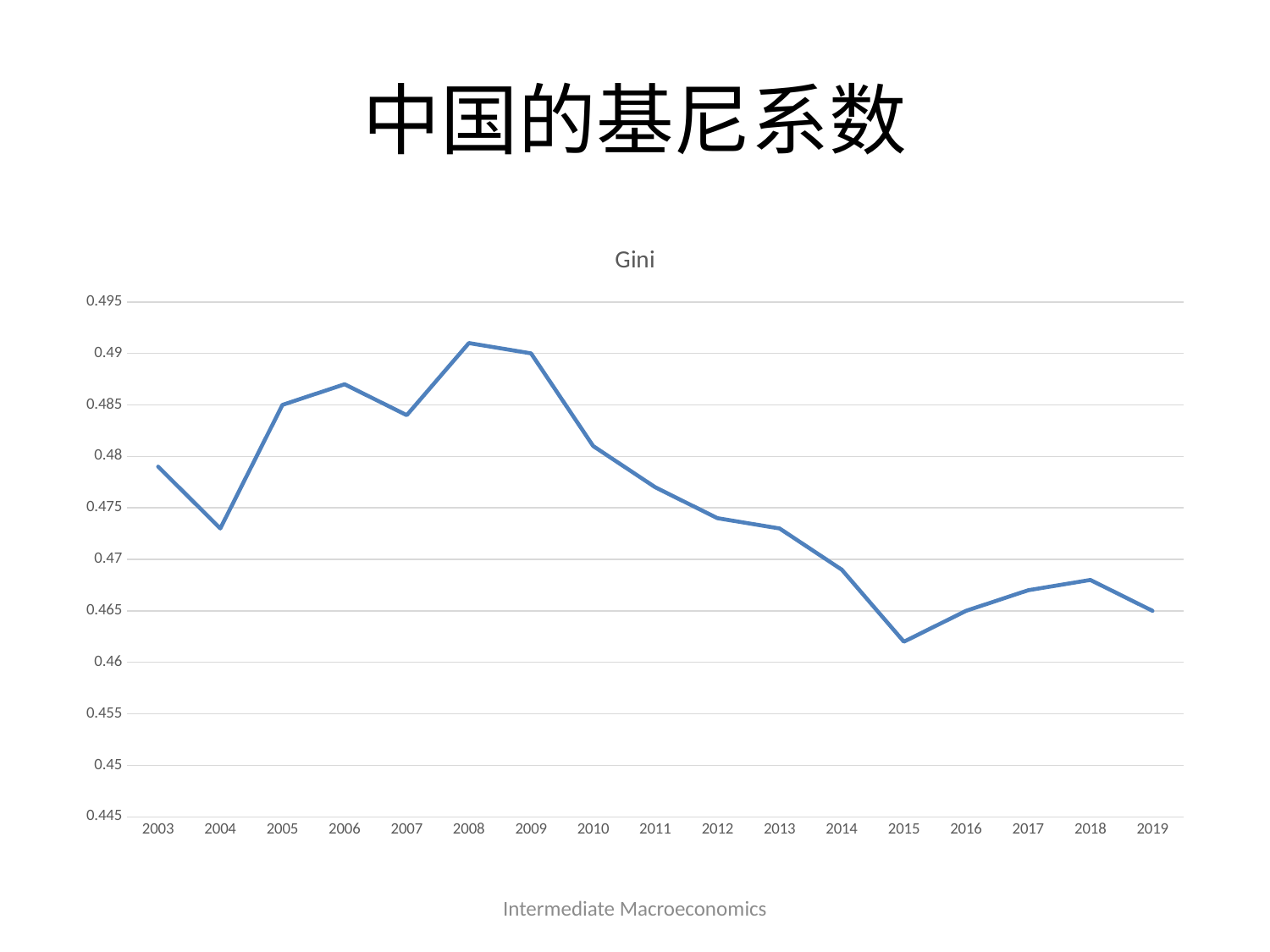
What is the Gini value for 2009? 0.49 Is the Gini value for 2015 greater or less than 0.465? less What is the Gini value for 2019? 0.465 Is the Gini value for 2003 greater or less than 0.475? greater What kind of chart is shown on the slide? line chart What is the title of the chart? Gini Which year has the lowest Gini value? 2015 How many years are plotted on the x axis? 17 Which year has the larger Gini value, 2008 or 2015? 2008 Is the Gini value for 2004 greater or less than 0.475? less What is the Gini value for 2005? 0.485 Does the Gini value rise or fall from 2009 to 2015? fall